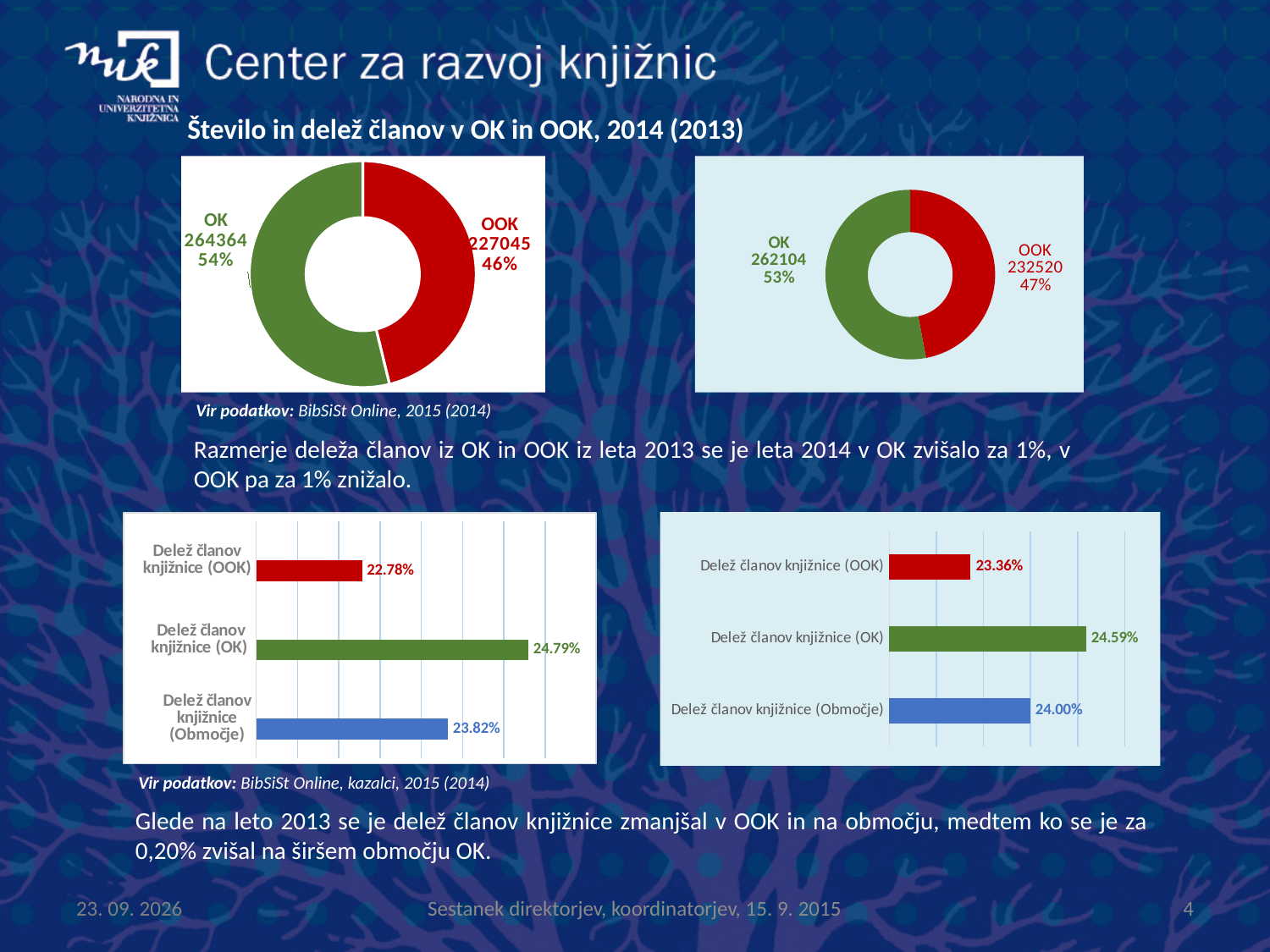
What type of chart is shown at the bottom left of the slide? Bar chart In the bottom-right bar chart, what is the value for Delež članov knjižnice (Območje)? 24.00% In the bottom-left bar chart, what is the value for Delež članov knjižnice (OK)? 24.79% In the bottom-right bar chart, which category has the highest value? Delež članov knjižnice (OK) In the top-right donut chart, what share of the total does OK hold? 53% In the top-left donut chart, what is the difference between the OK and OOK values? 37319 In the top-left donut chart, what share of the total does OOK hold? 46% In the bottom-right bar chart, what is the difference between the OK and OOK values? 1.23% In the bottom-left bar chart, which category has the lowest value? Delež članov knjižnice (OOK) In the top-left donut chart, what is the value shown for OK? 264364 In the top-right donut chart, what is the value shown for OOK? 232520 In the top-left donut chart, which segment is larger, OK or OOK? OK